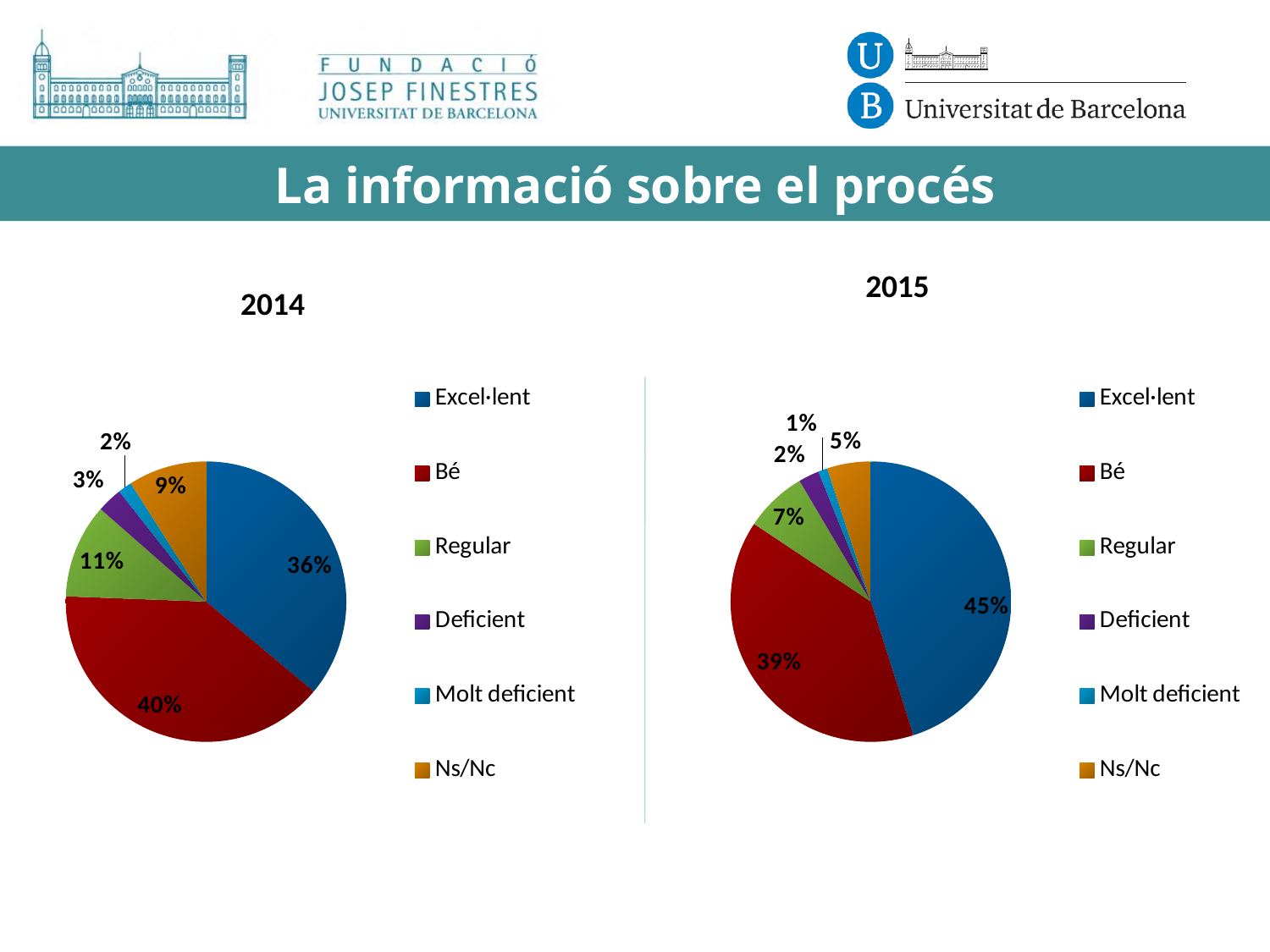
What kind of chart is used for the 2014 data? Pie chart In the 2014 pie chart, what share does Ns/Nc have? 9% In the 2015 pie chart, what share does Excel·lent have? 45% In the 2015 pie chart, which category has the smallest slice? Molt deficient In the 2015 pie chart, what is the difference between the Excel·lent and Bé shares? 6% In the 2014 pie chart, what share does Bé have? 40% In the 2014 pie chart, what share does Deficient have? 3% In the 2014 pie chart, which is larger, Regular or Ns/Nc? Regular In the 2014 pie chart, which category has the largest slice? Bé How many categories does the legend of the 2015 pie chart list? 6 In the 2015 pie chart, which colour represents Bé? Red In the 2015 pie chart, what share does Regular have? 7%